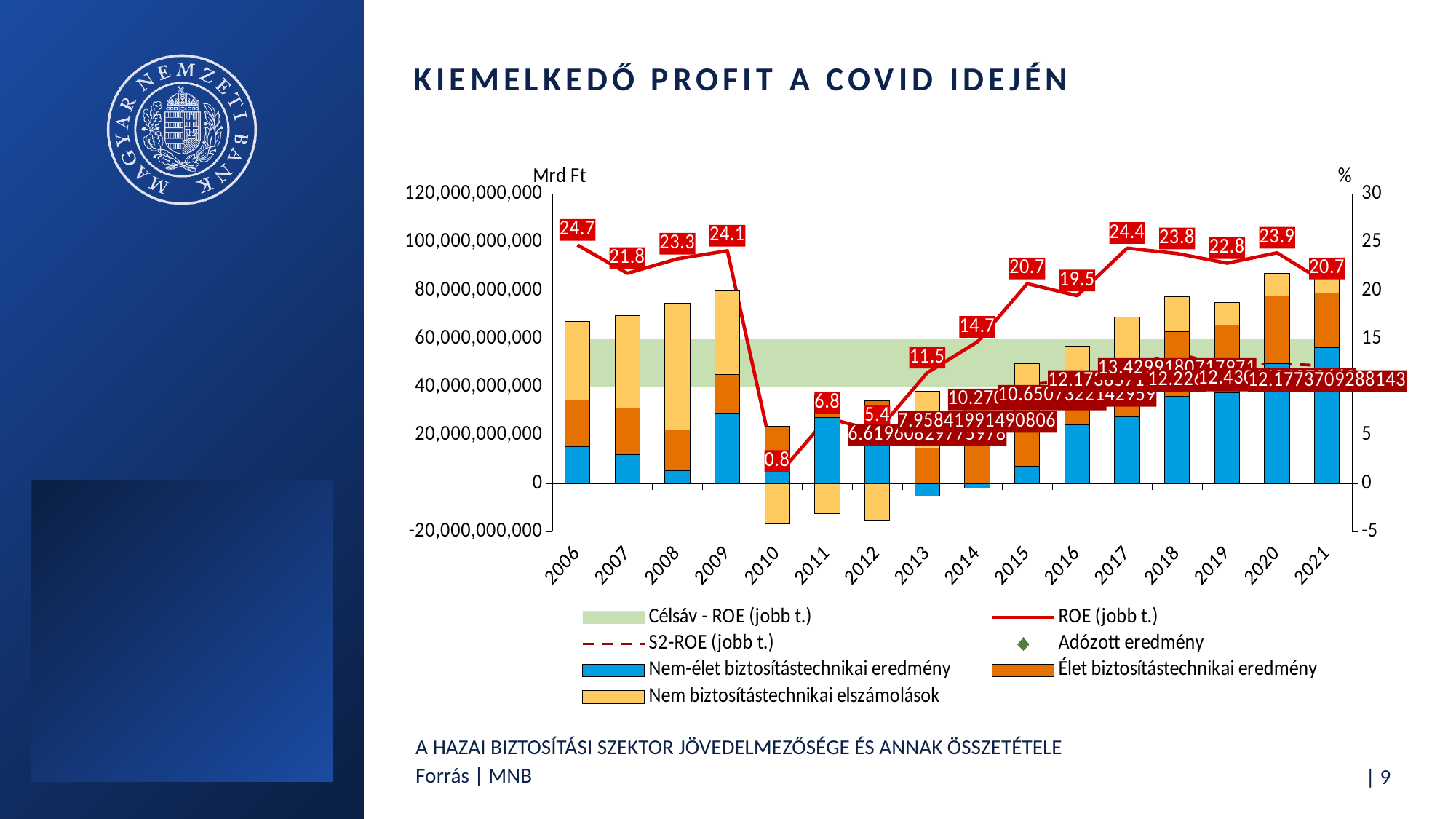
How many years are shown on the x axis? 16 What is the ROE (jobb t.) value for 2006? 24.7 In which year is the ROE (jobb t.) value lowest? 2010 What is the ROE (jobb t.) value for 2021? 20.7 What is the ROE (jobb t.) value for 2010? 0.8 Is the Nem-élet biztosítástechnikai eredmény value for 2020 greater or less than 40,000,000,000? greater Does the ROE (jobb t.) value rise or fall from 2010 to 2015? rise What is the title of the slide? KIEMELKEDŐ PROFIT A COVID IDEJÉN What is the difference between the ROE (jobb t.) values for 2006 and 2010? 23.9 How many series does the legend list? 7 Which year has a higher ROE (jobb t.) value, 2017 or 2018? 2017 In which year is the ROE (jobb t.) value highest? 2006